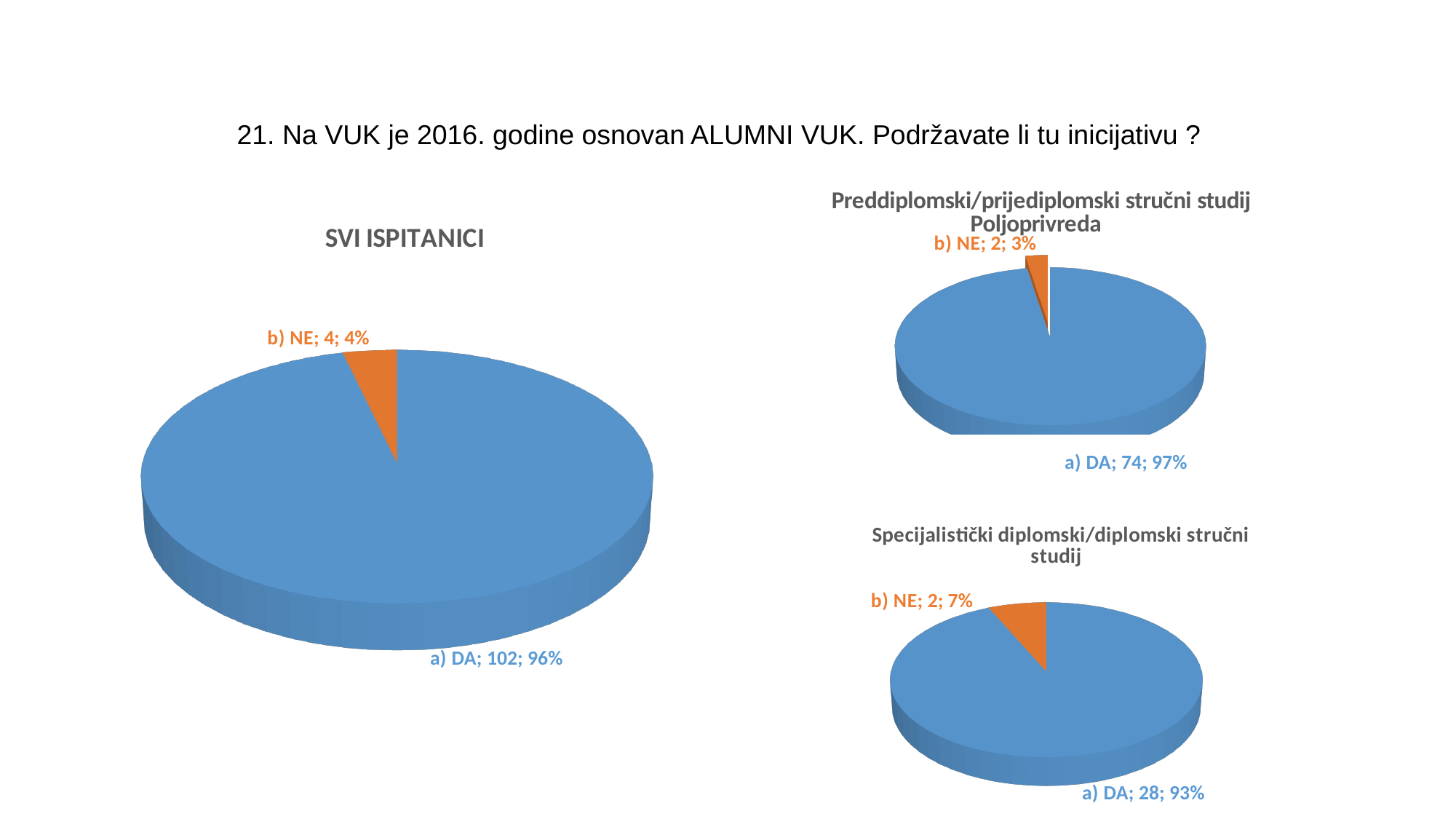
In the 'Preddiplomski/prijediplomski stručni studij Poljoprivreda' chart, how many respondents answered 'a) DA'? 74 In the 'Specijalistički diplomski/diplomski stručni studij' chart, what is the total number of respondents across both slices? 30 In the 'SVI ISPITANICI' chart, what is the difference between the counts for 'a) DA' and 'b) NE'? 98 In the 'SVI ISPITANICI' chart, what percentage share does 'b) NE' have? 4% In the 'Preddiplomski/prijediplomski stručni studij Poljoprivreda' chart, what percentage share does 'b) NE' have? 3% In the 'SVI ISPITANICI' chart, how many respondents answered 'a) DA'? 102 In the 'Preddiplomski/prijediplomski stručni studij Poljoprivreda' chart, which category is the smallest? b) NE In the 'SVI ISPITANICI' chart, which category is the largest? a) DA In the 'Specijalistički diplomski/diplomski stručni studij' chart, what percentage share does 'a) DA' have? 93% What type of chart is the 'SVI ISPITANICI' chart? Pie chart In the 'Specijalistički diplomski/diplomski stručni studij' chart, how many respondents answered 'b) NE'? 2 How many slices does the 'Specijalistički diplomski/diplomski stručni studij' chart have? 2